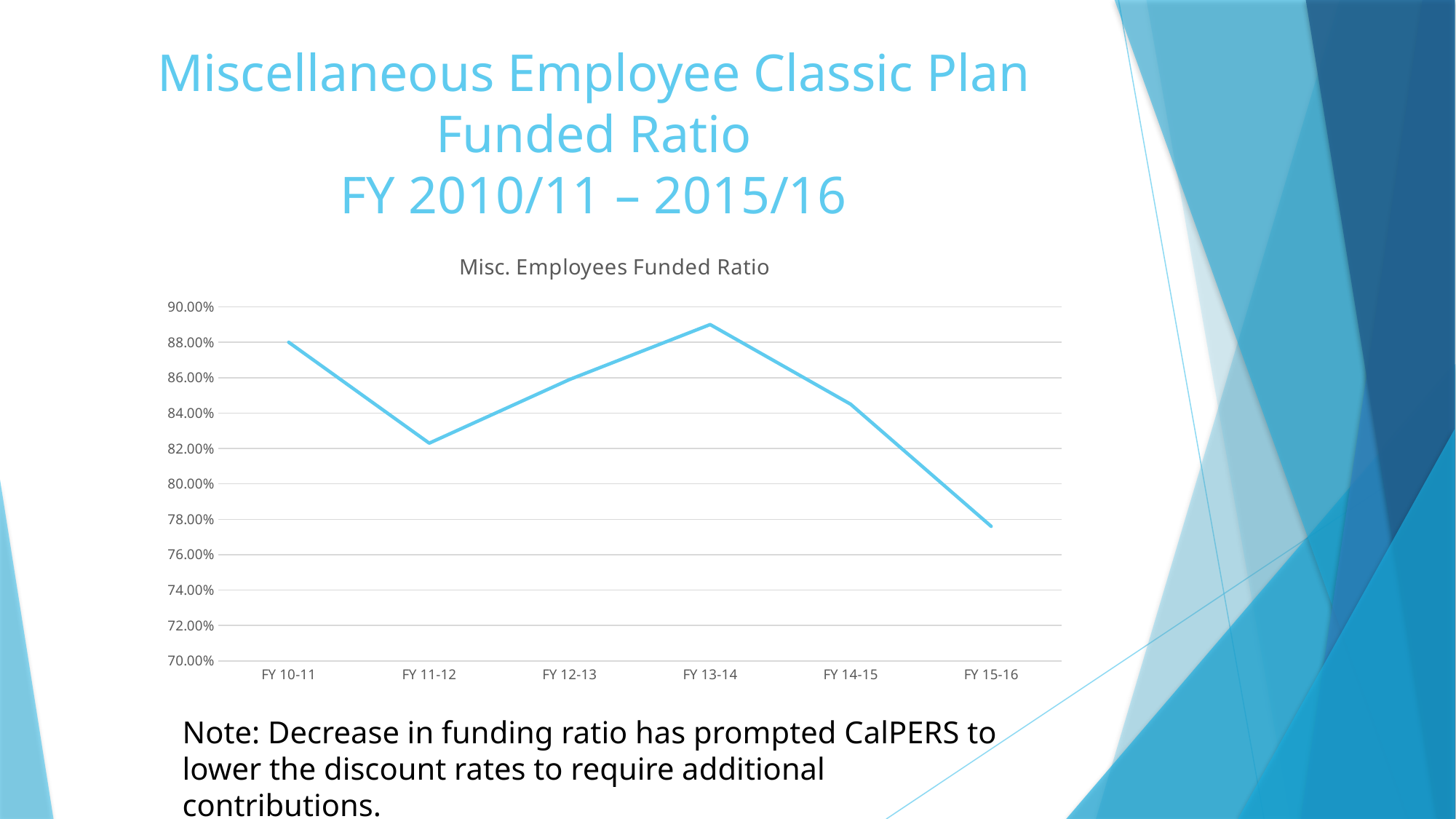
What kind of chart is shown on the slide? line chart Which fiscal year has the lowest funded ratio in the chart? FY 15-16 Which has a higher funded ratio, FY 14-15 or FY 15-16? FY 14-15 Which has a higher funded ratio, FY 10-11 or FY 11-12? FY 10-11 Which fiscal year has the highest funded ratio in the chart? FY 13-14 Does the funded ratio rise or fall from FY 13-14 to FY 15-16? fall What is the title of the chart? Misc. Employees Funded Ratio Is the funded ratio for FY 14-15 greater or less than 84.00%? greater Is the funded ratio for FY 11-12 greater or less than 84.00%? less Is the funded ratio for FY 13-14 greater or less than 88.00%? greater How many fiscal years are plotted on the x axis of the chart? 6